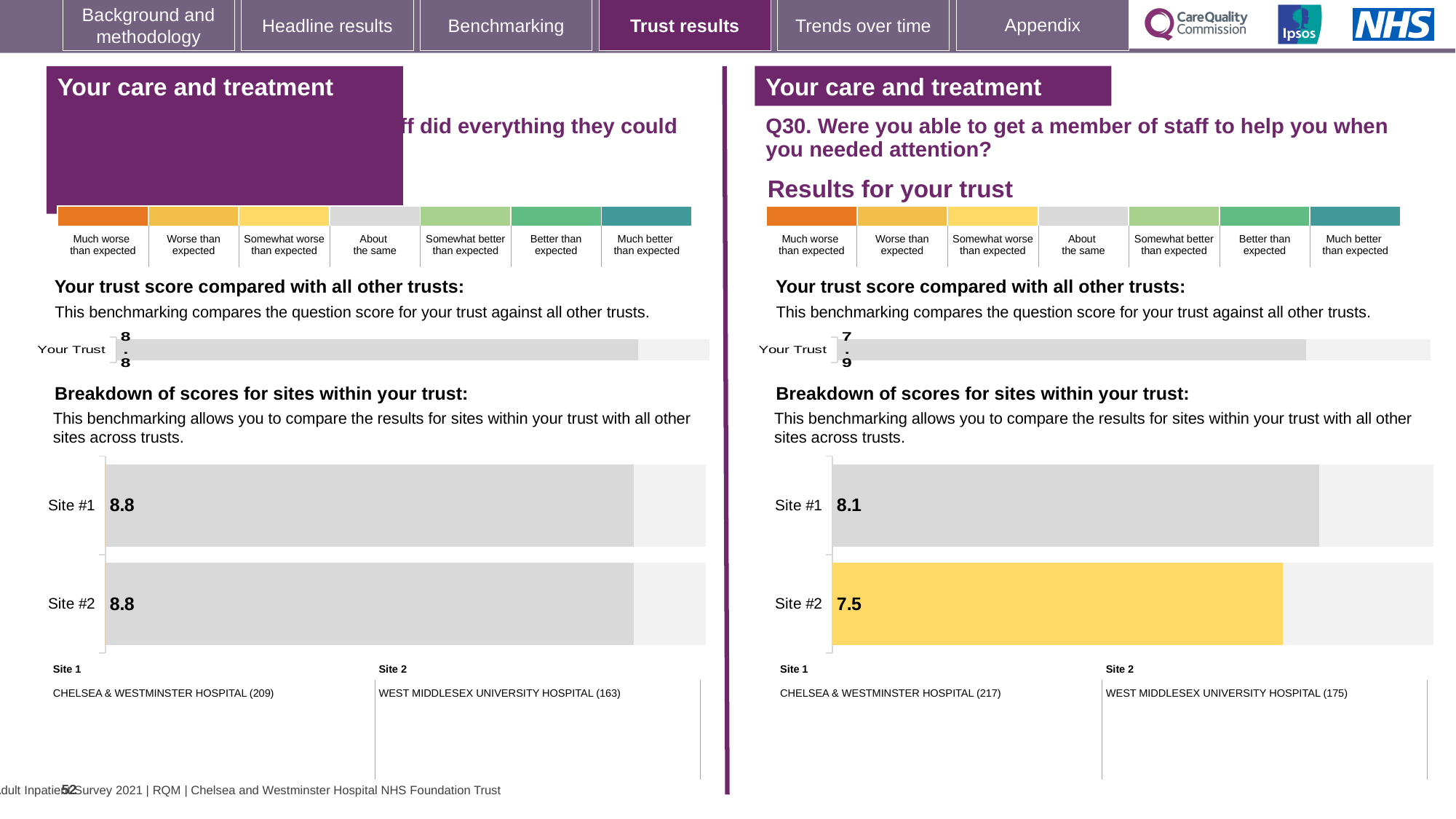
In the Q30 site breakdown chart, what is the difference between the Site #1 and Site #2 scores? 0.6 Which hospital is listed as Site 2 in the Q30 site breakdown? West Middlesex University Hospital (175) In the Q30 site breakdown chart, what colour is the bar for Site #2? Yellow What type of chart is used for the breakdown of scores for sites within your trust on the right-hand side? Bar chart In the Q30 site breakdown chart, which site has the lowest score? Site #2 On the left-hand side, what is the score shown for Your Trust? 8.8 In the Q30 site breakdown chart, which site has the higher score? Site #1 In the left-hand breakdown of scores for sites within your trust, what is the score for Site #2? 8.8 In the Q30 breakdown of scores for sites within your trust, what is the score for Site #1? 8.1 On the right-hand side (Q30), what is the score shown for Your Trust? 7.9 In the Q30 breakdown of scores for sites within your trust, what is the score for Site #2? 7.5 How many sites are shown in the Q30 breakdown of scores chart? 2